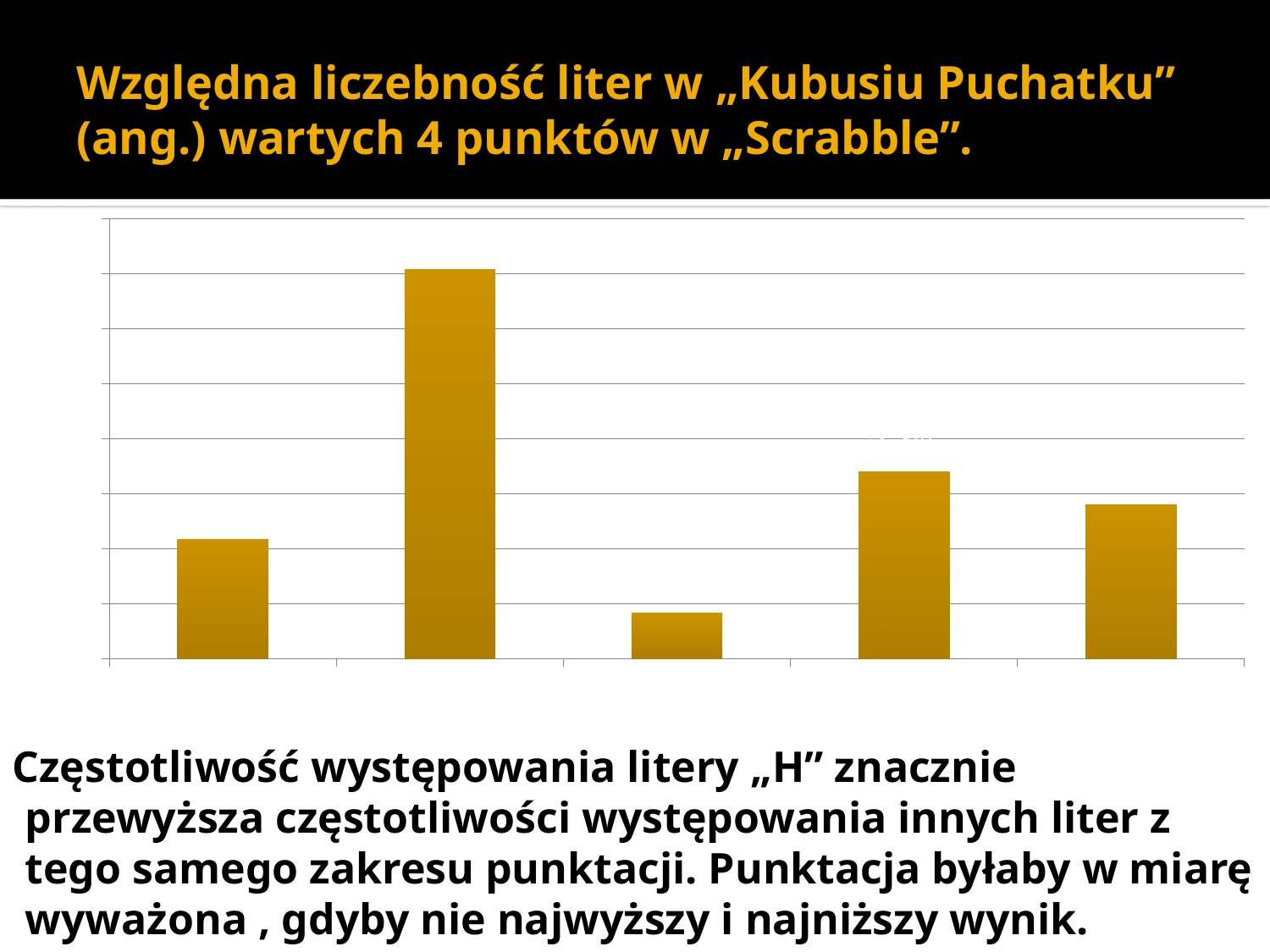
Which bar, counted from the left, is the tallest? the second bar Which is taller, the second bar from the left or the fourth bar? the second bar What kind of chart is shown on the slide? bar chart What colour are the bars in the chart? gold (dark yellow) Which bar, counted from the left, is the shortest? the third bar How many bars does the chart contain? 5 What is the title of the slide containing the chart? Względna liczebność liter w „Kubusiu Puchatku” (ang.) wartych 4 punktów w „Scrabble”. Which is taller, the fourth bar from the left or the fifth bar? the fourth bar Which is taller, the first bar from the left or the third bar? the first bar